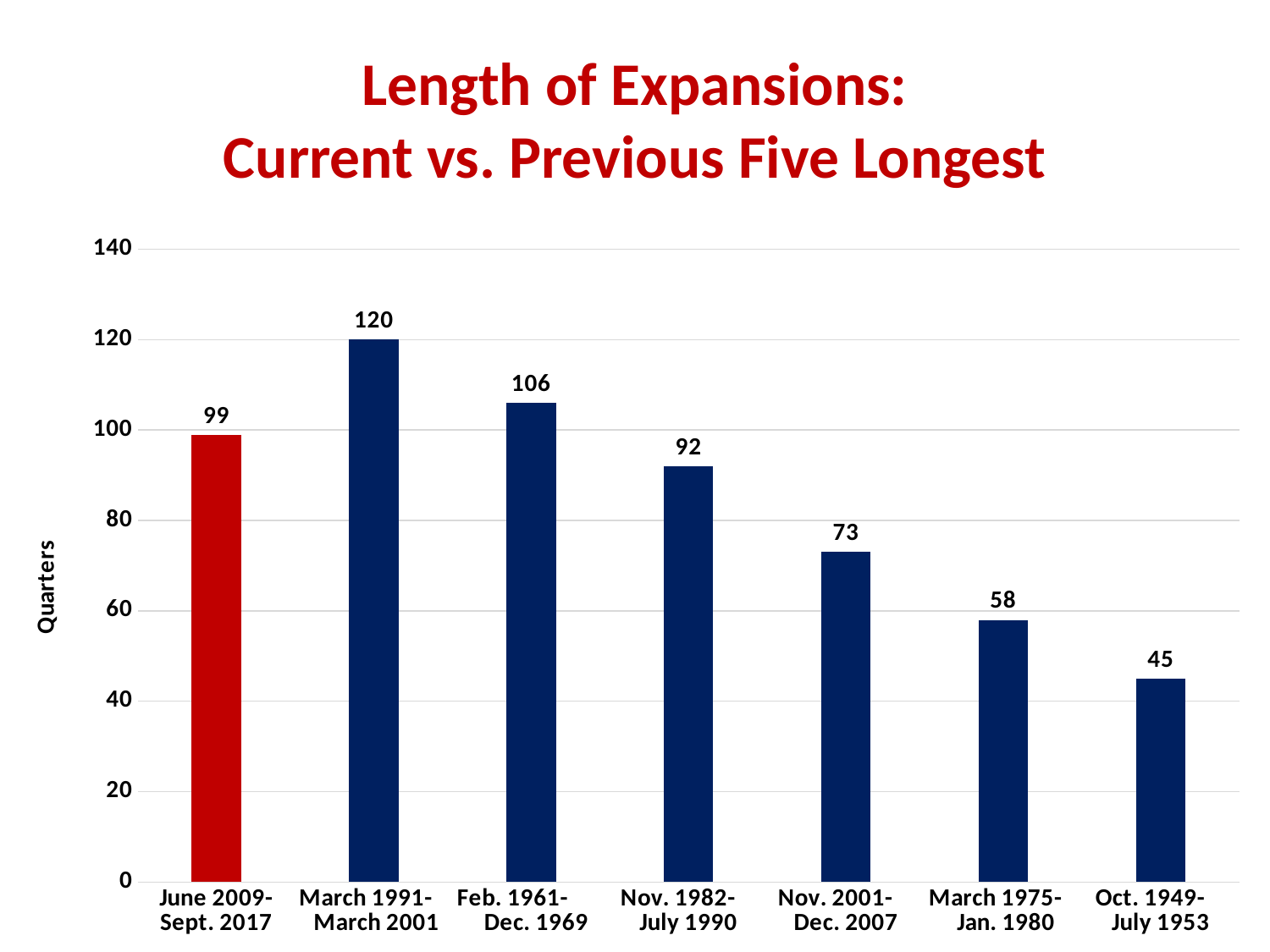
Which category has the lowest value? Oct. 1949-July 1953 What is the difference between the values for Feb. 1961-Dec. 1969 and Nov. 2001-Dec. 2007? 33 What is the value for June 2009-Sept. 2017? 99 What is the value for Nov. 1982-July 1990? 92 Is the value for Feb. 1961-Dec. 1969 greater or less than 100? greater Which is larger, the value for Nov. 2001-Dec. 2007 or the value for March 1975-Jan. 1980? Nov. 2001-Dec. 2007 What is the value for Oct. 1949-July 1953? 45 What is the label on the vertical axis? Quarters How many categories are shown on the chart? 7 What kind of chart is shown on the slide? bar chart Which category has the highest value? March 1991-March 2001 What is the difference between the values for March 1991-March 2001 and June 2009-Sept. 2017? 21